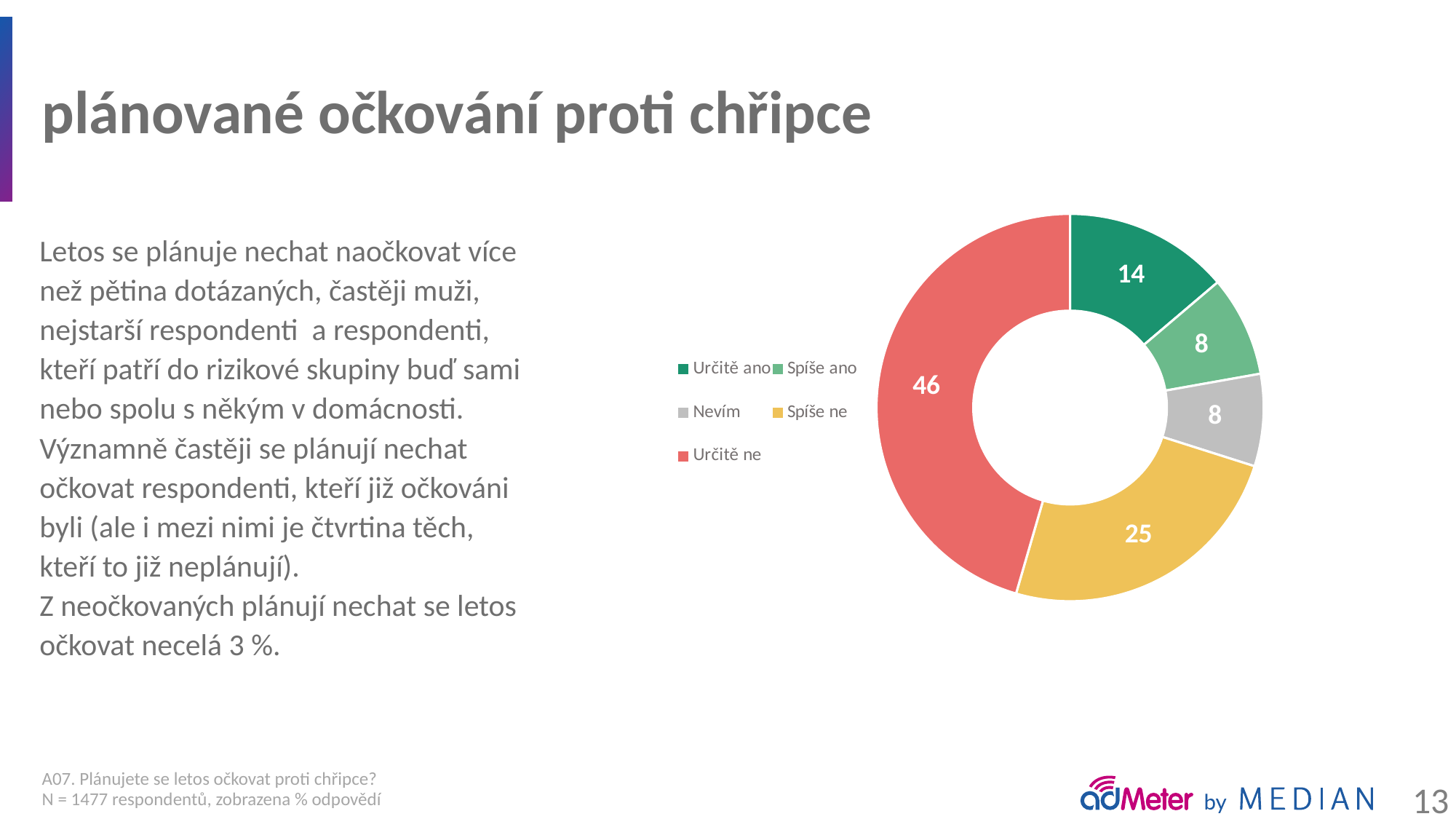
Which is larger, the value for 'Spíše ne' or the value for 'Určitě ano'? Spíše ne What is the combined value of the 'Určitě ano' and 'Spíše ano' slices? 22 What value is shown for the 'Určitě ano' slice? 14 Which category has the largest slice? Určitě ne What value is shown for the 'Spíše ne' slice? 25 What is the difference between the values for 'Určitě ne' and 'Spíše ne'? 21 What is the difference between the values for 'Určitě ano' and 'Spíše ano'? 6 What kind of chart is shown on the slide? doughnut chart What value is shown for the 'Nevím' slice? 8 Which colour is used for the 'Určitě ne' slice? red What value is shown for the 'Určitě ne' slice? 46 How many categories does the chart show? 5